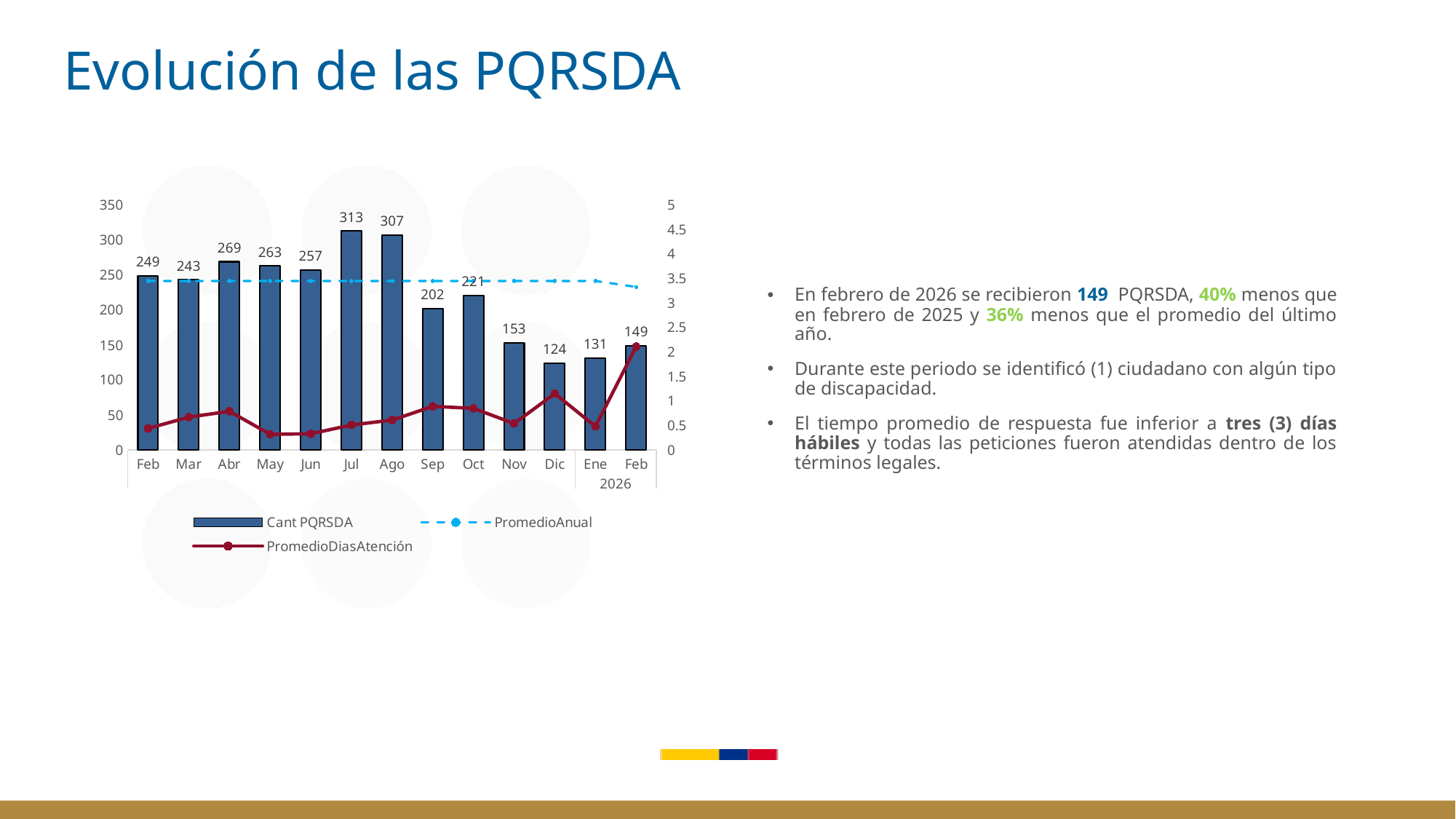
What is the Cant PQRSDA value for Feb 2026? 149 Which month has the highest Cant PQRSDA bar? Jul Do the Cant PQRSDA values rise or fall from Jul to Dic? fall What kind of chart is shown on the slide? bar and line chart What is the difference between the Cant PQRSDA values for the first Feb bar and Feb 2026? 100 Which has a larger Cant PQRSDA value, Abr or May? Abr How many series does the legend list? 3 Is the PromedioDiasAtención value for Feb 2026 greater or less than 1.5 on the right axis? greater What is the Cant PQRSDA value for Jul? 313 How many bars are plotted in the chart? 13 Which month has the lowest Cant PQRSDA bar? Dic What is the difference between the Cant PQRSDA values for Jul and Ago? 6